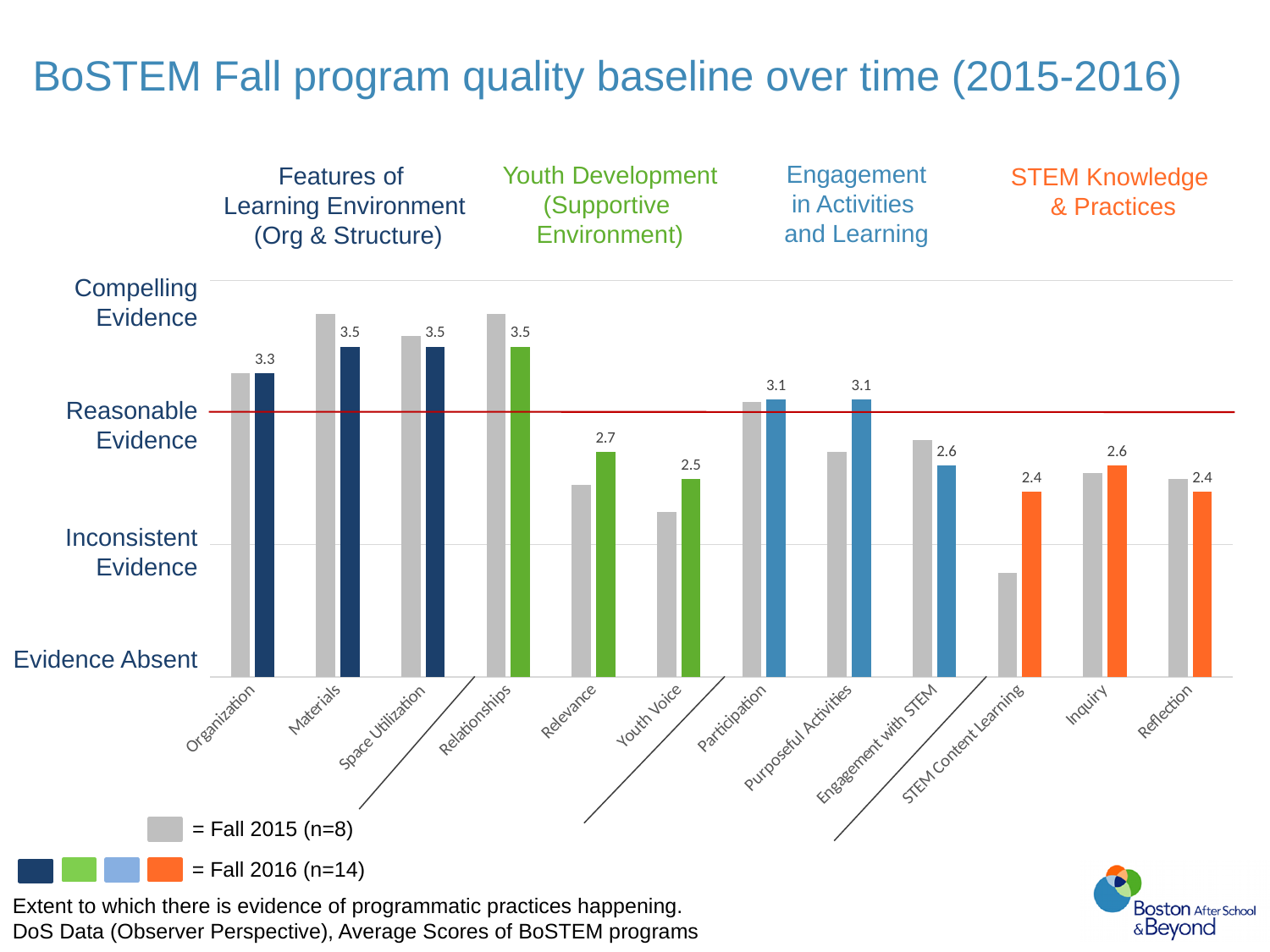
Among the Youth Development (Supportive Environment) categories, which has the lowest Fall 2016 value? Youth Voice What kind of chart is shown on the slide? Bar chart What is the Fall 2016 value for Relevance? 2.7 What is the Fall 2016 value for Youth Voice? 2.5 For STEM Content Learning, which is larger: the Fall 2015 bar or the Fall 2016 bar? Fall 2016 What is the Fall 2016 value for Organization? 3.3 How many categories are shown along the x axis? 12 What is the Fall 2016 value for Engagement with STEM? 2.6 How many data series does the legend list? 2 What is the difference between the Fall 2016 values for Materials and Organization? 0.2 What is the Fall 2016 value for STEM Content Learning? 2.4 What is the difference between the Fall 2016 values for Relevance and Youth Voice? 0.2